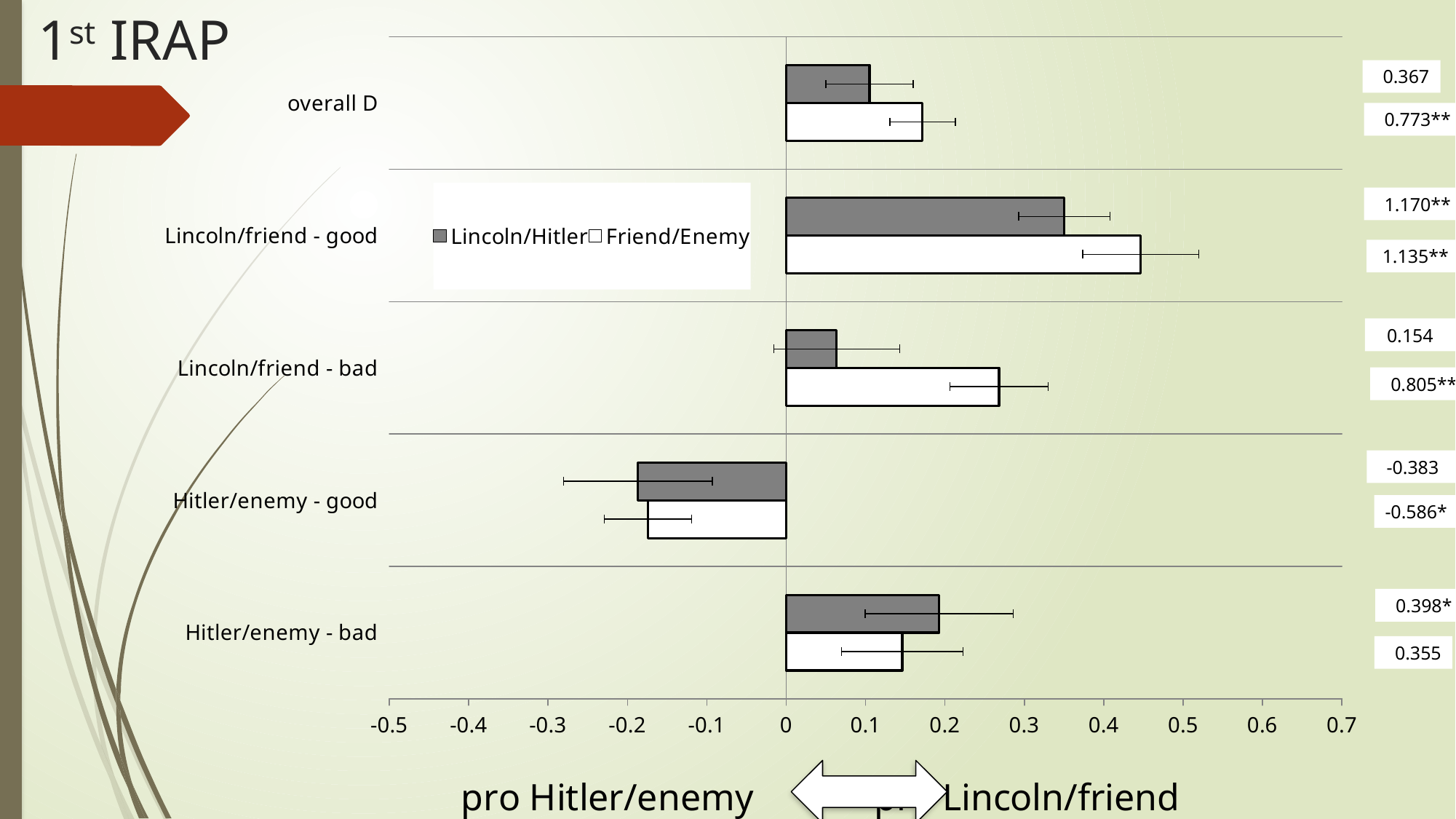
Is the Friend/Enemy value for Lincoln/friend - bad greater or less than 0.2? greater What are the two series names listed in the legend? Lincoln/Hitler and Friend/Enemy For Lincoln/friend - bad, which series has the larger value, Lincoln/Hitler or Friend/Enemy? Friend/Enemy Is the Lincoln/Hitler value for overall D greater or less than 0.2? less Which category has the highest Friend/Enemy value? Lincoln/friend - good Is the Friend/Enemy value for Lincoln/friend - good greater or less than 0.4? greater How many categories are plotted on the chart? 5 How many series does the legend list? 2 Which category has the lowest Lincoln/Hitler value? Hitler/enemy - good For Hitler/enemy - bad, which series has the larger value, Lincoln/Hitler or Friend/Enemy? Lincoln/Hitler What kind of chart is shown on the slide? bar chart